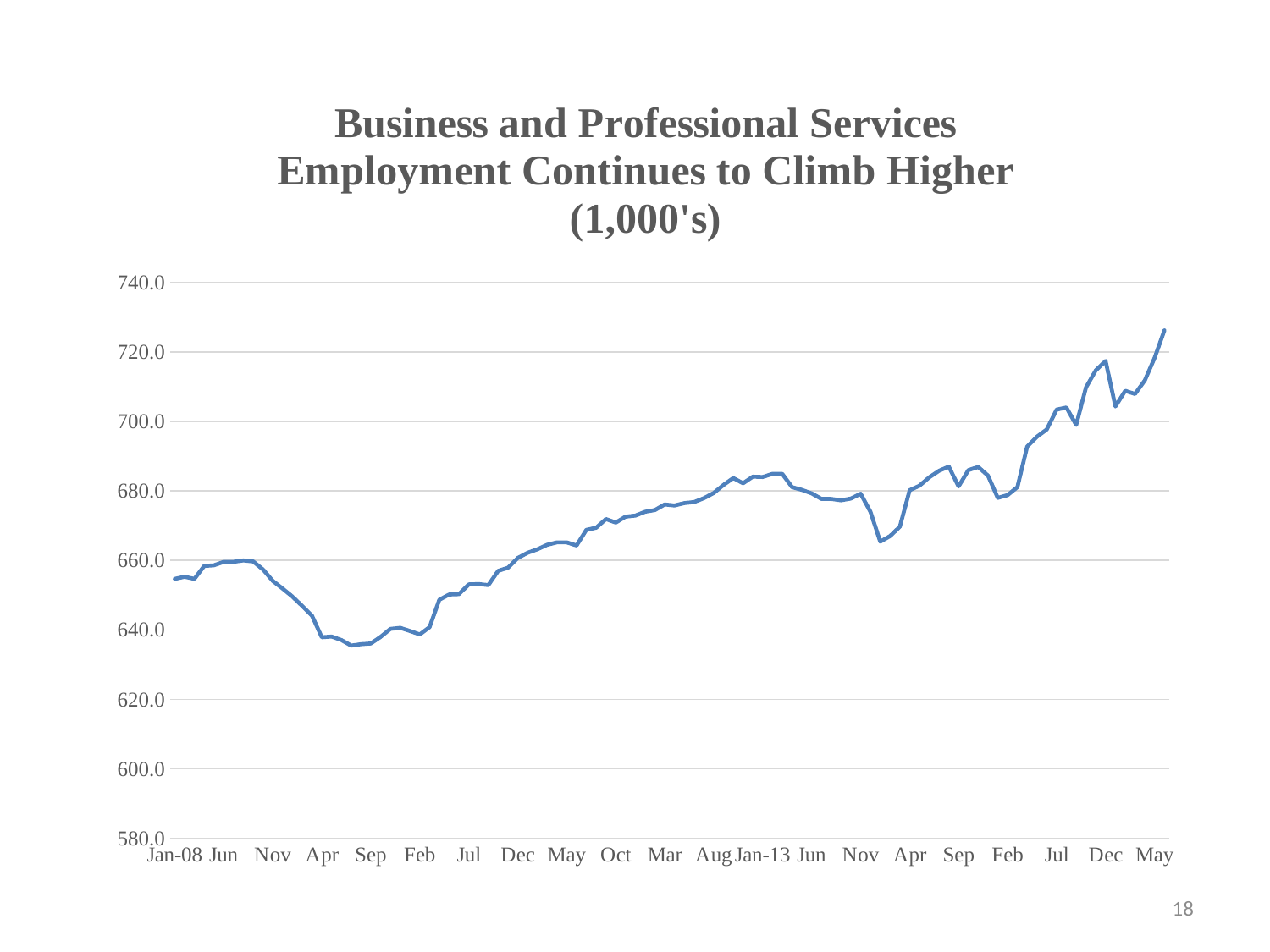
Is the value at the first Jul on the x axis greater or less than 660? less What is the title of the chart? Business and Professional Services Employment Continues to Climb Higher (1,000's) Overall, does the line rise or fall from Jan-08 to the final May on the x axis? rise What kind of chart is shown on the slide? line chart Is the value at Jan-13 greater or less than 680? greater How many lines are plotted on the chart? 1 Is the value at Jan-08 greater or less than 640? greater What is the highest value shown on the y axis? 740.0 Which is larger, the value at Jan-08 or the value at Jan-13? Jan-13